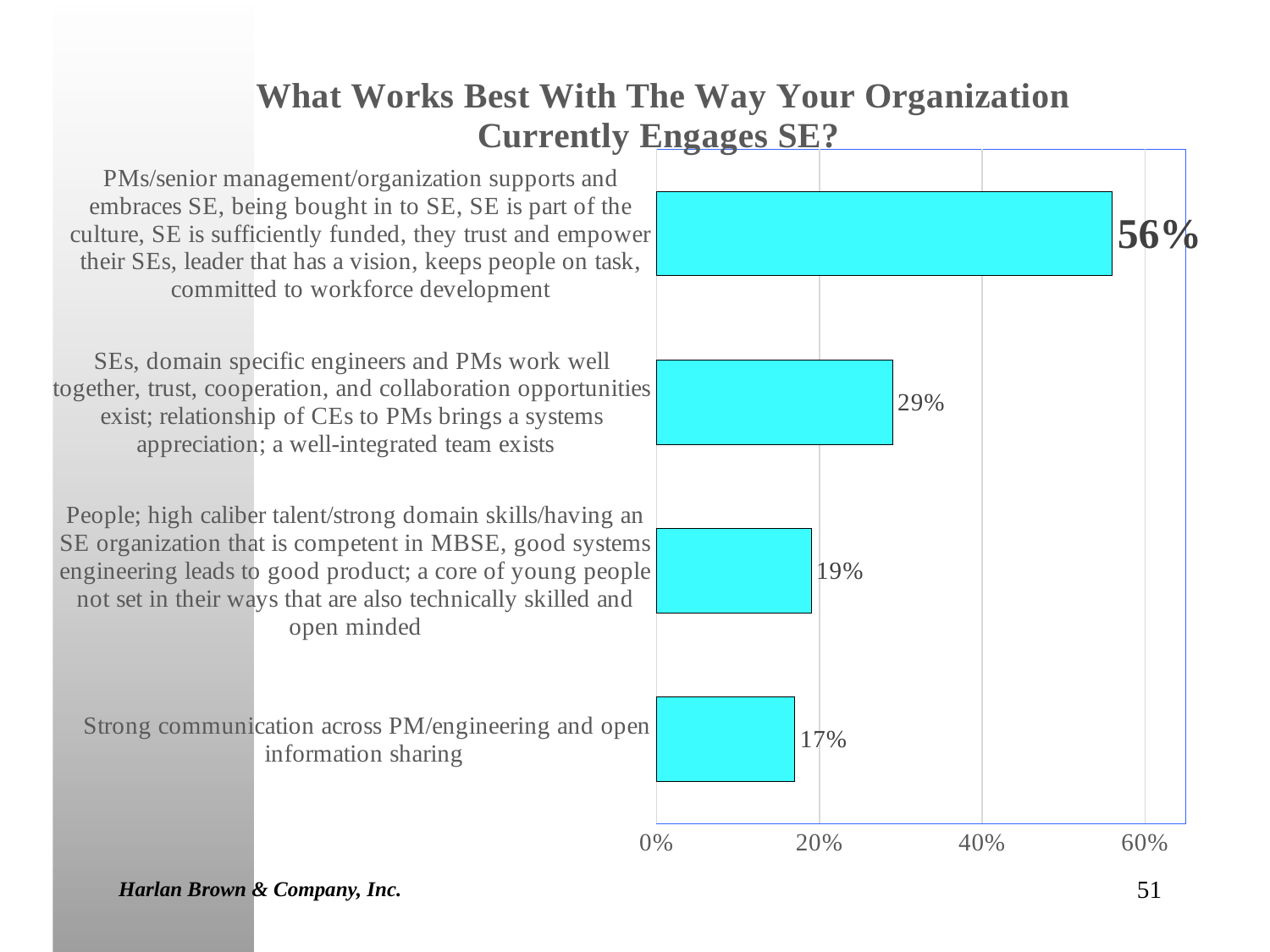
What is the value for the category beginning 'SEs, domain specific engineers and PMs work well together'? 29% What is the difference between the values for the 'People; high caliber talent' category and the 'Strong communication' category? 2% What kind of chart is shown on the slide? bar chart Which is larger: the value for the 'SEs, domain specific engineers and PMs work well together' category or the 'People; high caliber talent' category? SEs, domain specific engineers and PMs work well together What is the title of the chart? What Works Best With The Way Your Organization Currently Engages SE? What is the difference between the highest value (56%) and the value for the 'SEs, domain specific engineers and PMs work well together' category? 27% Is the value for the top category (PMs/senior management/organization supports and embraces SE) greater or less than 40%? greater Which category has the lowest value? Strong communication across PM/engineering and open information sharing How many categories are shown in the chart? 4 What is the value for the category 'Strong communication across PM/engineering and open information sharing'? 17% What is the value for the category beginning 'People; high caliber talent/strong domain skills'? 19%